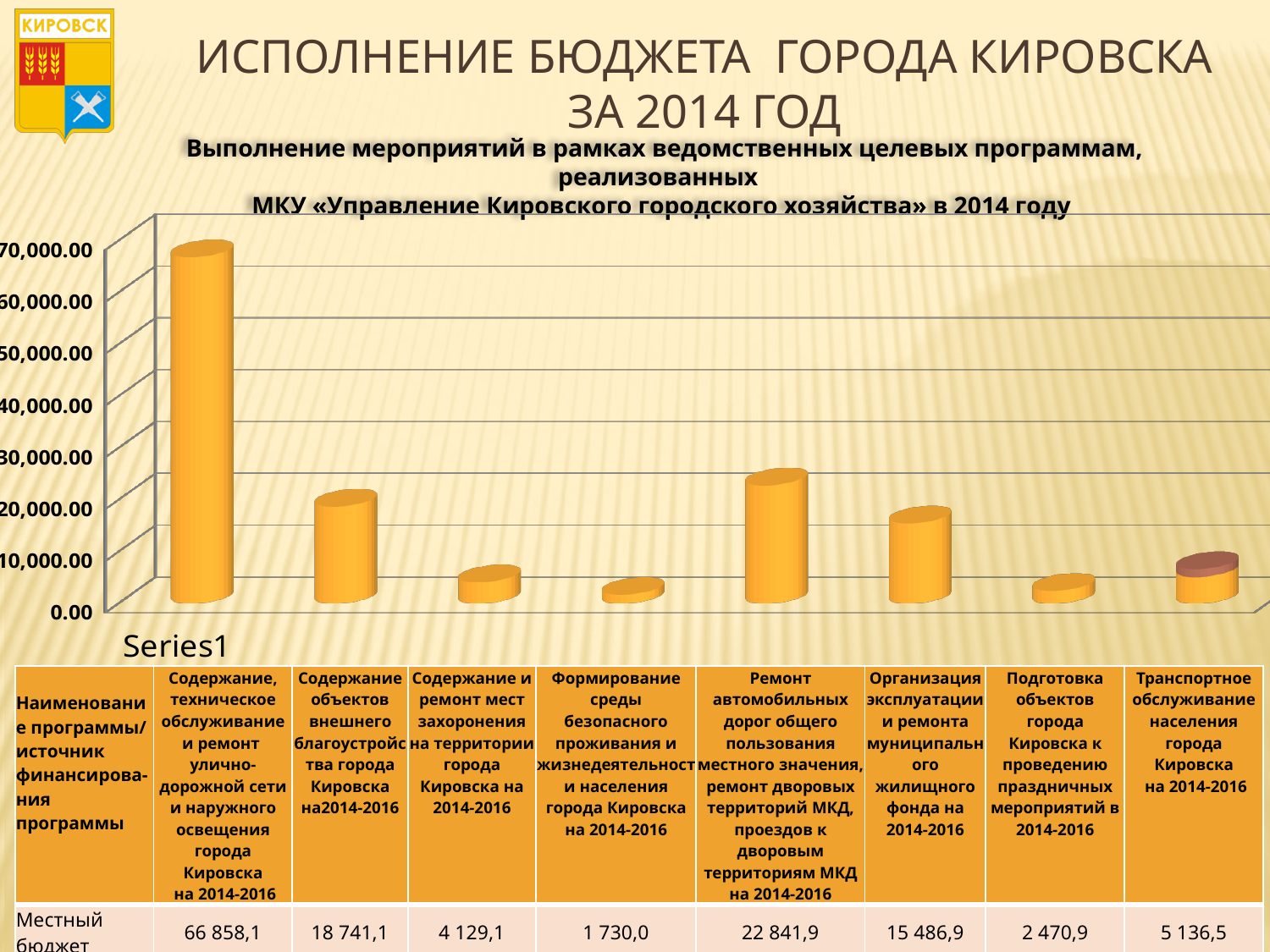
How many series does the chart legend list? 1 Which programme has the lowest bar in the chart? Формирование среды безопасного проживания и жизнедеятельности населения города Кировска на 2014-2016 What is the legend entry shown below the chart? Series1 How many bars (programmes) are plotted in the chart? 8 What kind of chart is shown on the slide? bar chart Which is larger: the bar for 'Ремонт автомобильных дорог общего пользования местного значения...' or the bar for 'Организация эксплуатации и ремонта муниципального жилищного фонда на 2014-2016'? Ремонт автомобильных дорог общего пользования местного значения, ремонт дворовых территорий МКД, проездов к дворовым территориям МКД на 2014-2016 Which programme has the highest bar in the chart? Содержание, техническое обслуживание и ремонт улично-дорожной сети и наружного освещения города Кировска на 2014-2016 Using the values in the table under the chart, what is the difference between 'Содержание объектов внешнего благоустройства города Кировска на 2014-2016' (18 741,1) and 'Организация эксплуатации и ремонта муниципального жилищного фонда на 2014-2016' (15 486,9)? 3 254,2 According to the table under the chart, what is the local budget value for 'Ремонт автомобильных дорог общего пользования местного значения, ремонт дворовых территорий МКД, проездов к дворовым территориям МКД на 2014-2016'? 22 841,9 Is the bar for 'Содержание объектов внешнего благоустройства города Кировска на 2014-2016' greater or less than 10,000.00? greater According to the table under the chart, what is the local budget value for 'Транспортное обслуживание населения города Кировска на 2014-2016'? 5 136,5 Is the bar for 'Подготовка объектов города Кировска к проведению праздничных мероприятий в 2014-2016' greater or less than 10,000.00? less